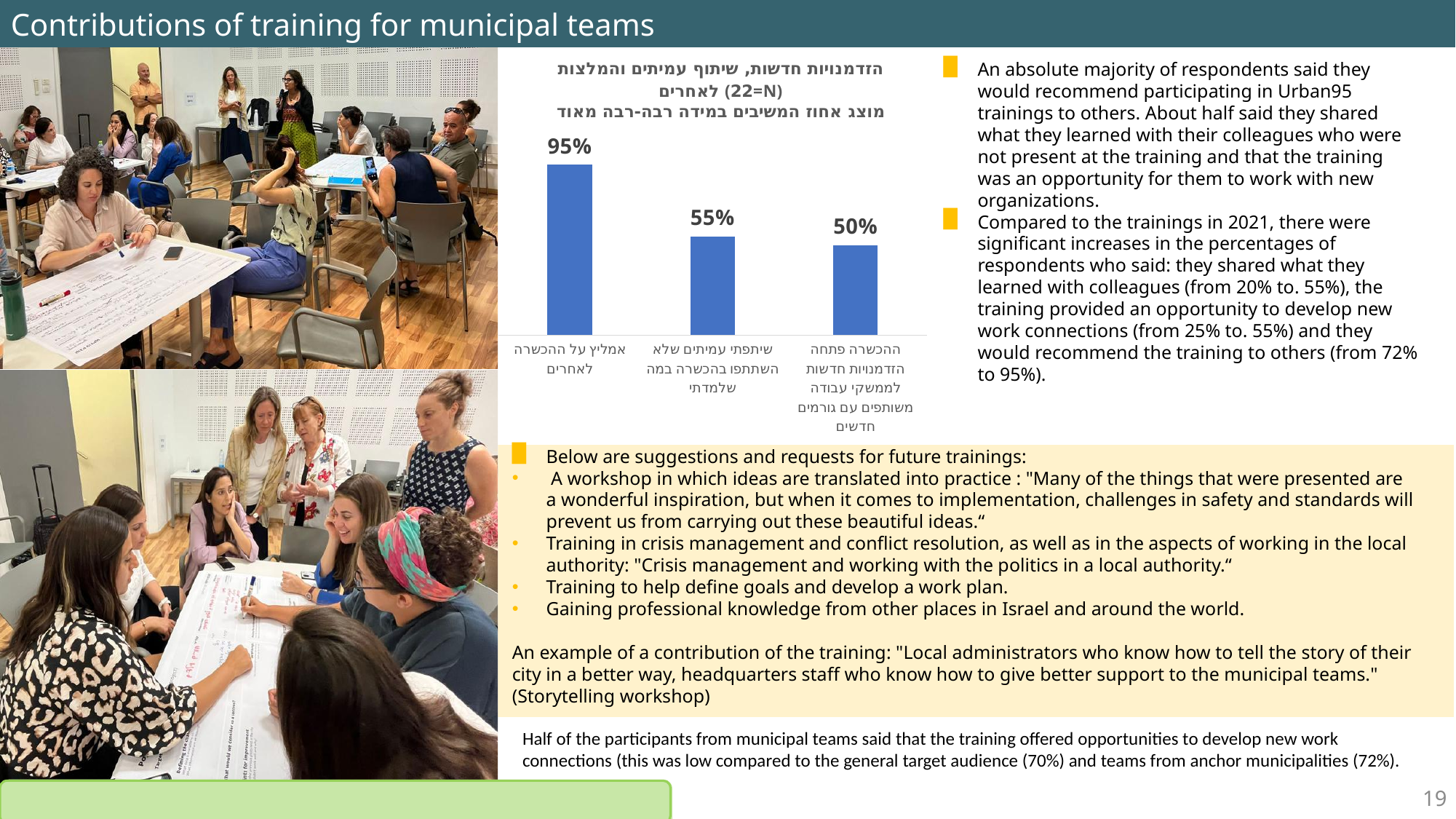
How many bars does the chart show? 3 What sample size (N) is stated in the chart title? N=22 What kind of chart is shown on the slide? bar chart What is the difference between the middle bar (55%) and the rightmost bar (50%)? 5% What is the difference between the leftmost bar (95%) and the middle bar (55%)? 40% Which category has the highest value in the chart? אמליץ על ההכשרה לאחרים Do the bar values rise or fall from left to right across the chart? fall What is the value of the leftmost bar, labelled "אמליץ על ההכשרה לאחרים"? 95% What is the value of the middle bar, labelled "שיתפתי עמיתים שלא השתתפו בהכשרה במה שלמדתי"? 55% What is the value of the rightmost bar, labelled "ההכשרה פתחה הזדמנויות חדשות לממשקי עבודה משותפים עם גורמים חדשים"? 50% Which category has the lowest value in the chart? ההכשרה פתחה הזדמנויות חדשות לממשקי עבודה משותפים עם גורמים חדשים Which is larger: the value for "אמליץ על ההכשרה לאחרים" or the value for "שיתפתי עמיתים שלא השתתפו בהכשרה במה שלמדתי"? אמליץ על ההכשרה לאחרים